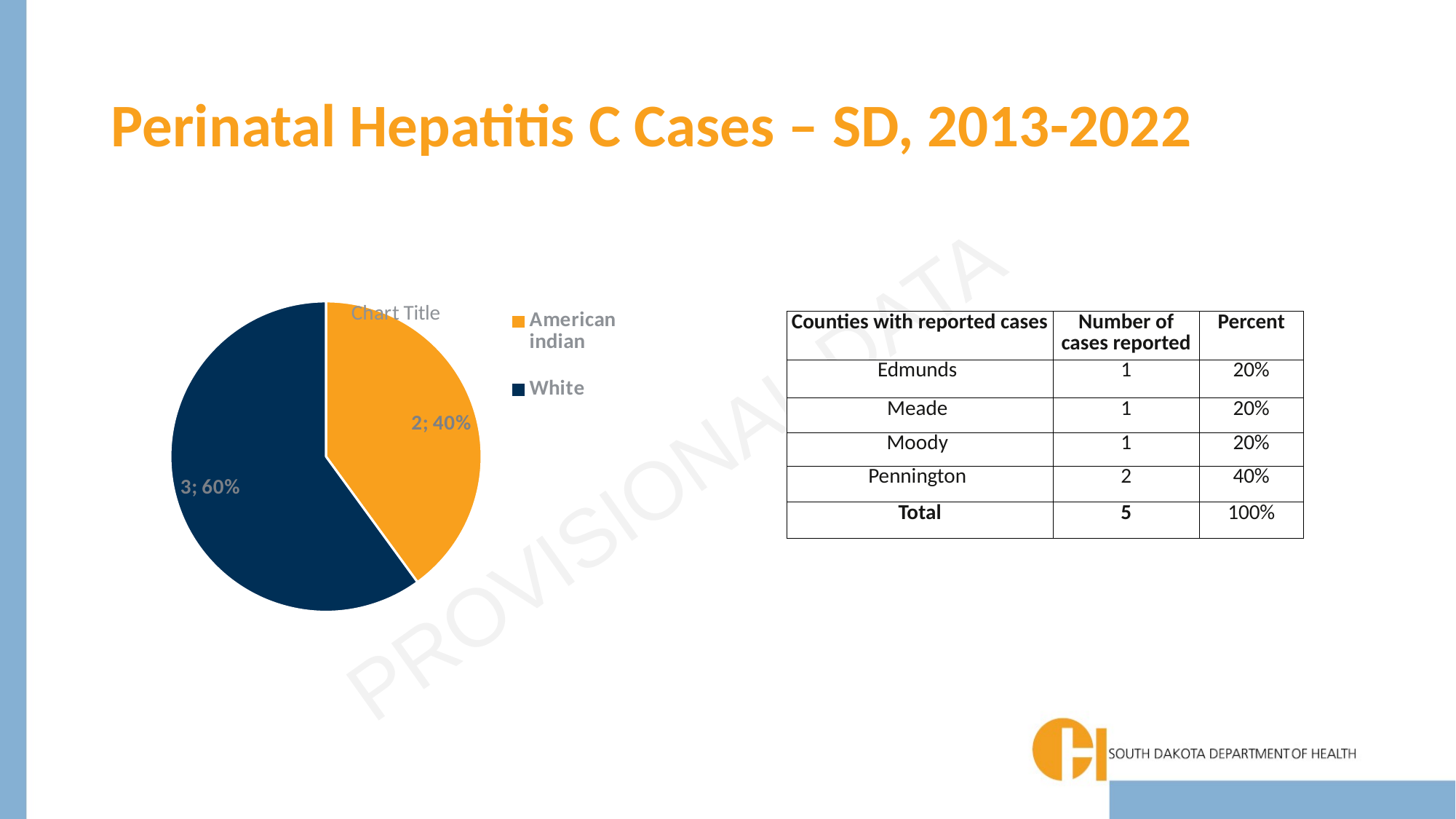
Which category has the smallest slice in the pie chart? American indian What share of the pie does the White slice represent? 60% What is the number of cases for White in the pie chart? 3 What kind of chart is shown on the slide? pie chart How many entries does the pie chart's legend list? 2 What is the number of cases for American indian in the pie chart? 2 What is the difference in number of cases between White and American indian in the pie chart? 1 Which category has the largest slice in the pie chart? White Which is larger in the pie chart, the White slice or the American indian slice? White What colour is the White slice in the pie chart? dark blue How many slices does the pie chart have? 2 What share of the pie does the American indian slice represent? 40%